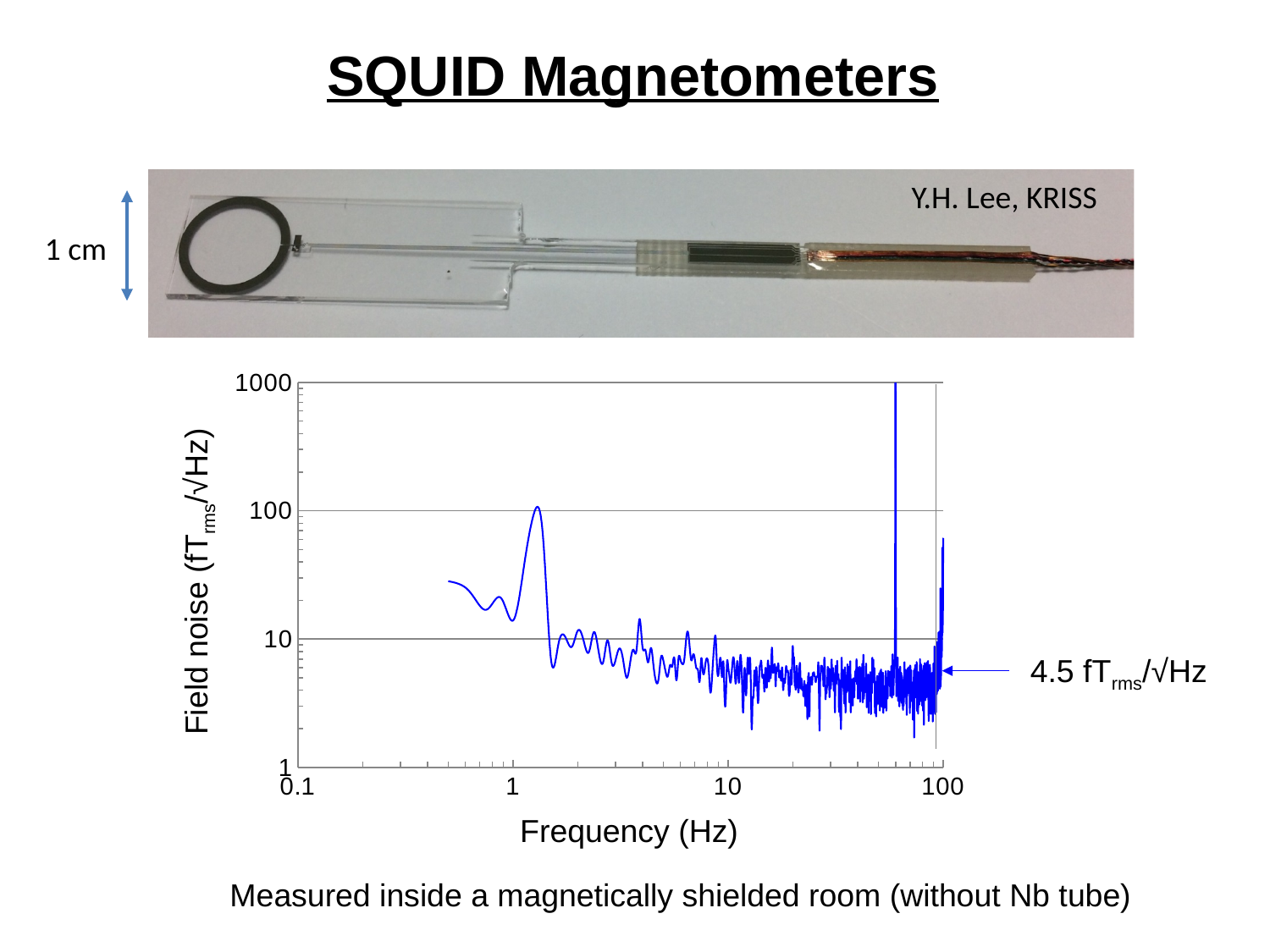
What is the label of the y axis of the chart? Field noise (fTrms/√Hz) What field noise value is annotated with an arrow at the high-frequency end of the chart? 4.5 fTrms/√Hz Does the field noise generally rise or fall as frequency increases from about 1.5 Hz to 50 Hz? fall How many data series are plotted on the chart? 1 Is the field noise at the peak just above 1 Hz greater or less than 10? greater What is the highest value shown on the y axis of the chart? 1000 Is the field noise at the narrow spike near 60 Hz greater or less than 100? greater What kind of chart is shown on the slide? line chart What is the label of the x axis of the chart? Frequency (Hz) Is the field noise at 0.5 Hz greater or less than 10? greater Which is larger, the field noise at the peak near 1.3 Hz or the field noise at 20 Hz? the peak near 1.3 Hz